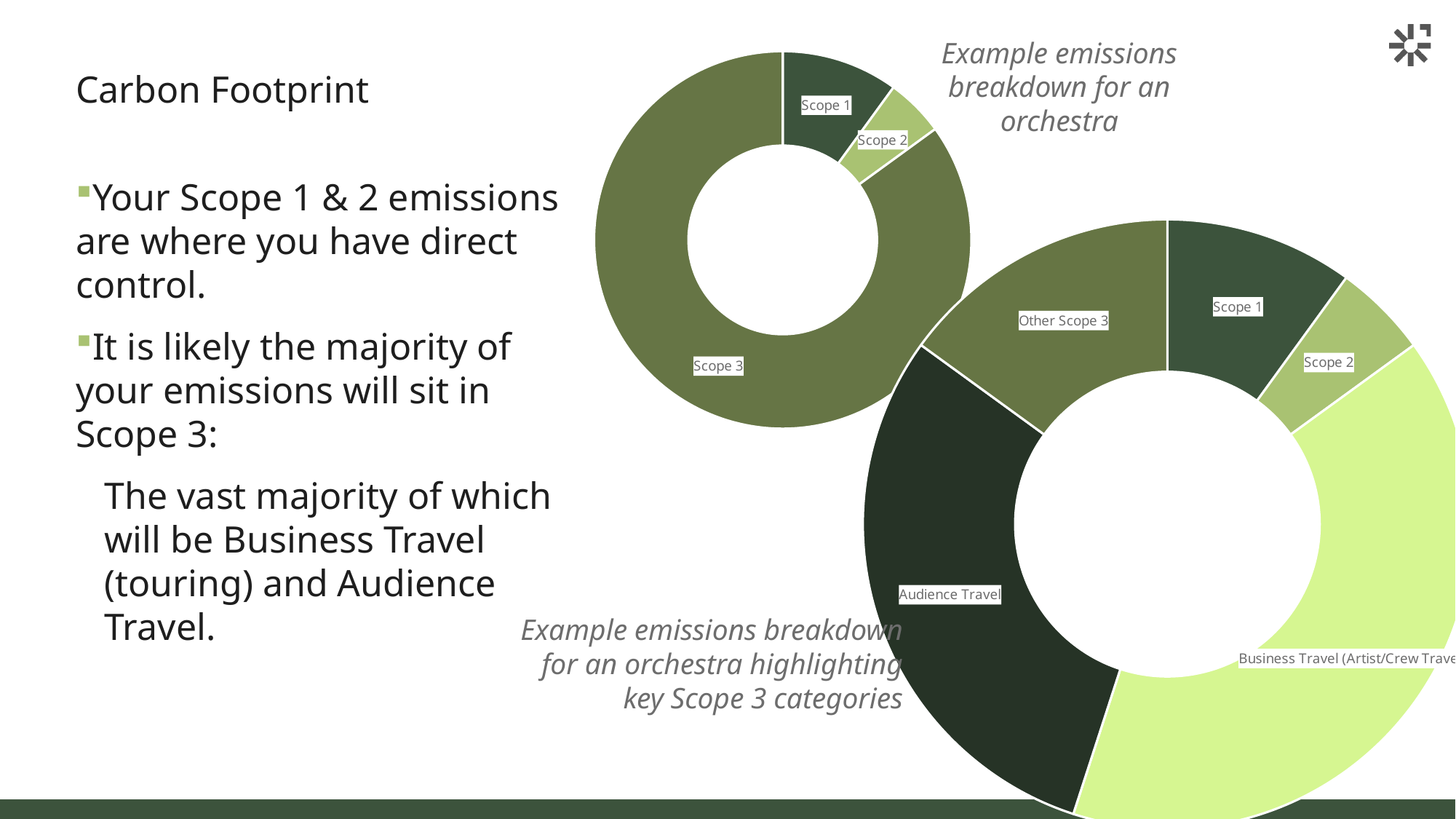
What kind of chart is the bottom chart highlighting key Scope 3 categories? Doughnut (pie) chart What kind of chart is the top chart titled 'Example emissions breakdown for an orchestra'? Doughnut (pie) chart In the bottom chart highlighting key Scope 3 categories, how many segments are there? 5 In the top chart 'Example emissions breakdown for an orchestra', which scope has the smallest share? Scope 2 In the bottom chart highlighting key Scope 3 categories, which is larger, Other Scope 3 or Scope 1? Other Scope 3 In the top chart 'Example emissions breakdown for an orchestra', how many segments are there? 3 In the top chart 'Example emissions breakdown for an orchestra', which scope has the largest share? Scope 3 What is the caption of the top chart on the slide? Example emissions breakdown for an orchestra In the bottom chart highlighting key Scope 3 categories, which is larger, Audience Travel or Other Scope 3? Audience Travel In the top chart 'Example emissions breakdown for an orchestra', which is larger, Scope 1 or Scope 2? Scope 1 In the bottom chart highlighting key Scope 3 categories, which segment is the smallest? Scope 2 What is the caption of the bottom chart on the slide? Example emissions breakdown for an orchestra highlighting key Scope 3 categories